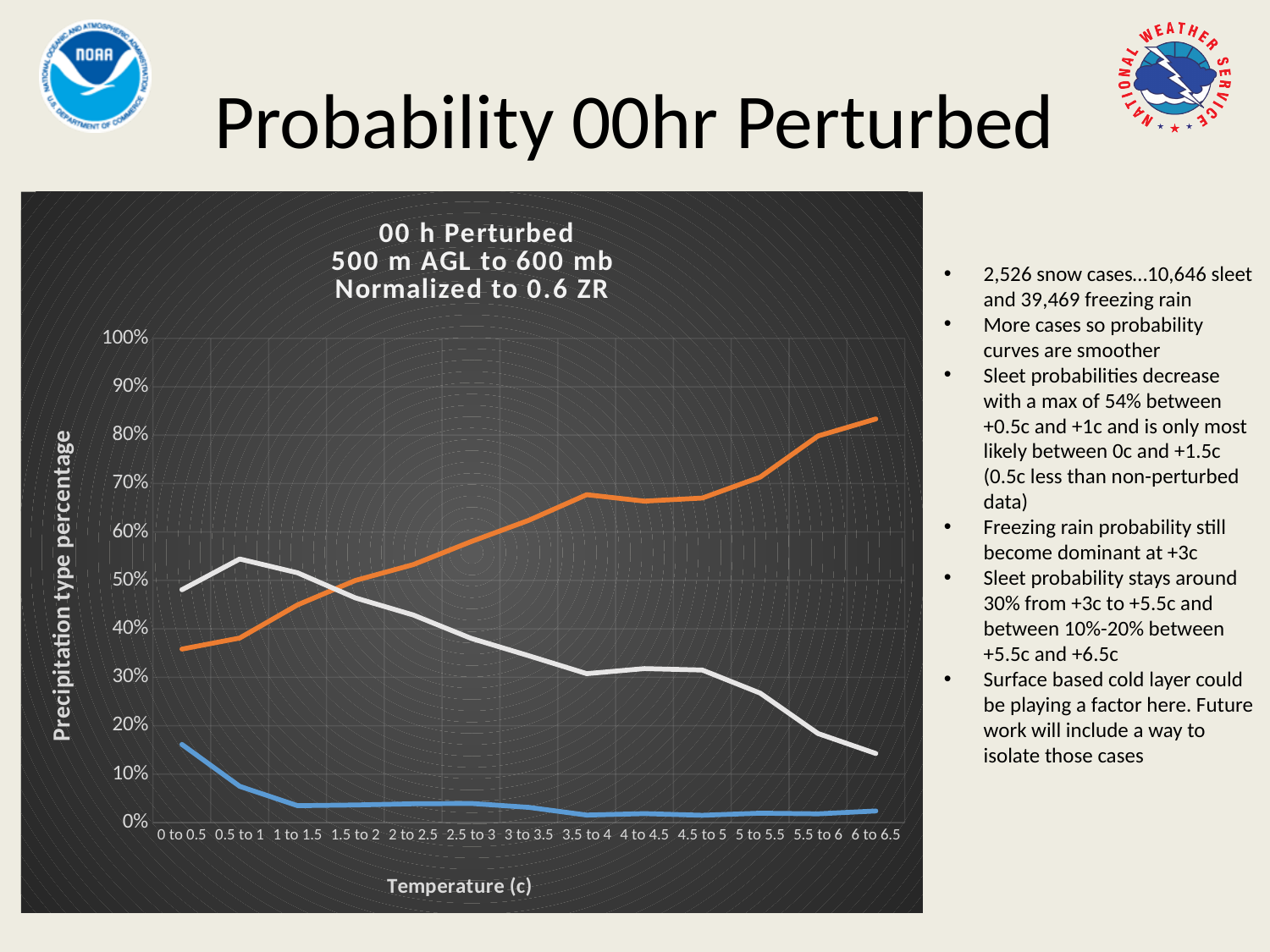
At the 0 to 0.5 category, which line has the larger value, the white line or the orange line? white line Is the value of the white line at 6 to 6.5 greater or less than 20%? less What kind of chart is shown on the slide? line chart Does the orange line rise or fall as temperature increases along the x axis? rise At which temperature category does the white line reach its highest value? 0.5 to 1 Is the value of the orange line at 6 to 6.5 greater or less than 80%? greater What is the label of the chart's y axis? Precipitation type percentage How many temperature categories are shown along the x axis of the chart? 13 How many lines are plotted on the chart? 3 At which temperature category does the orange line reach its highest value? 6 to 6.5 Does the white line rise or fall overall from the 0.5 to 1 category to the 6 to 6.5 category? fall Is the value of the blue line at 0 to 0.5 greater or less than 10%? greater